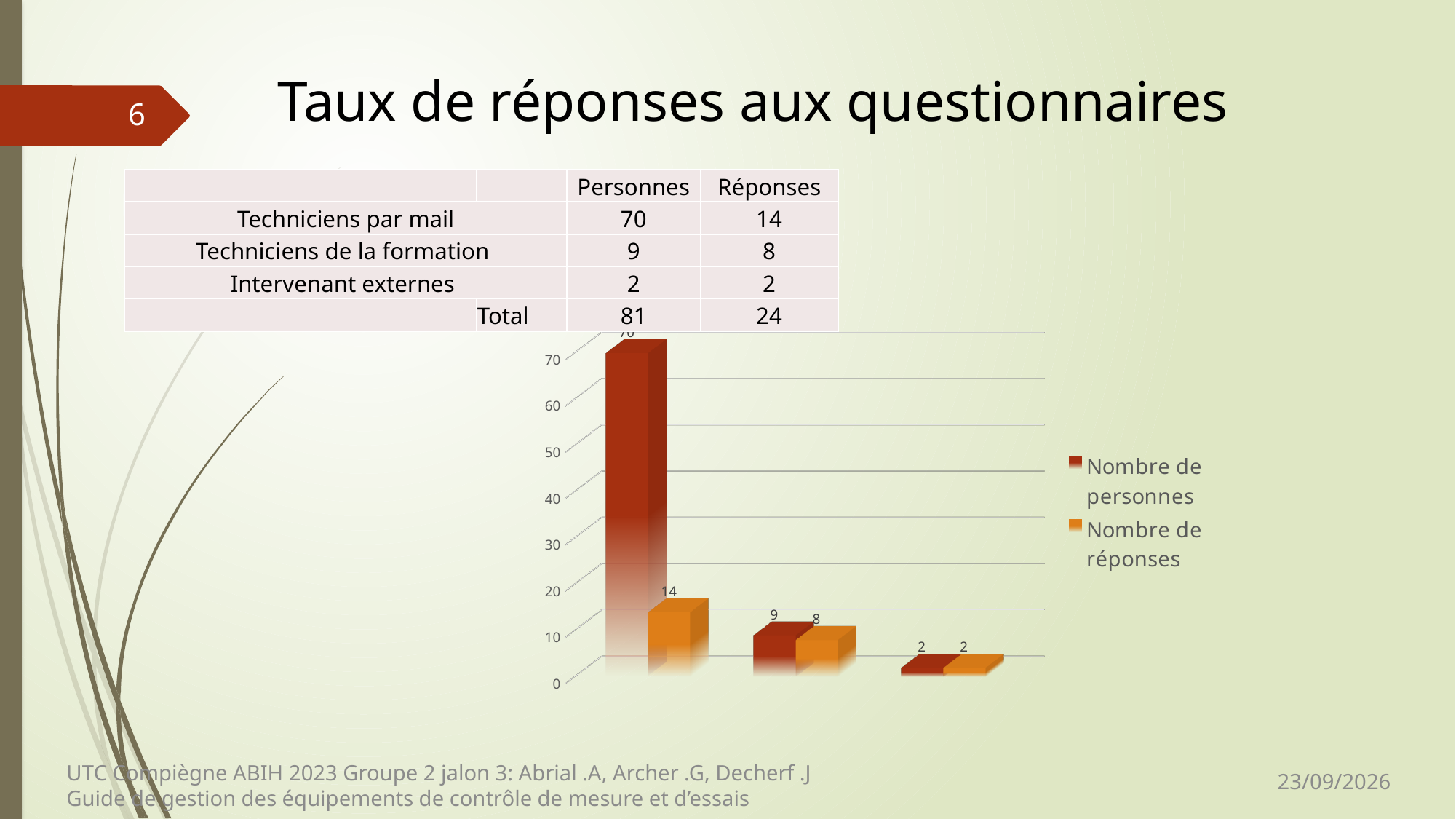
What is the value of 'Nombre de personnes' for the third group of bars in the chart? 2 What is the value of 'Nombre de personnes' for the second group of bars in the chart? 9 In the chart, what is the difference between 'Nombre de personnes' and 'Nombre de réponses' for the second group of bars? 1 What is the value of 'Nombre de réponses' for the second group of bars in the chart? 8 In the chart, which is larger: 'Nombre de réponses' for the first group or 'Nombre de personnes' for the second group? Nombre de réponses for the first group What is the value of 'Nombre de réponses' for the first group of bars in the chart? 14 How many series does the chart legend list? 2 Which group of bars has the highest 'Nombre de personnes' value in the chart? the first group In the chart, what is the difference between 'Nombre de personnes' and 'Nombre de réponses' for the first group of bars? 56 How many groups of bars are plotted in the chart? 3 What kind of chart is shown on the slide? bar chart What are the two series names listed in the chart legend? Nombre de personnes; Nombre de réponses